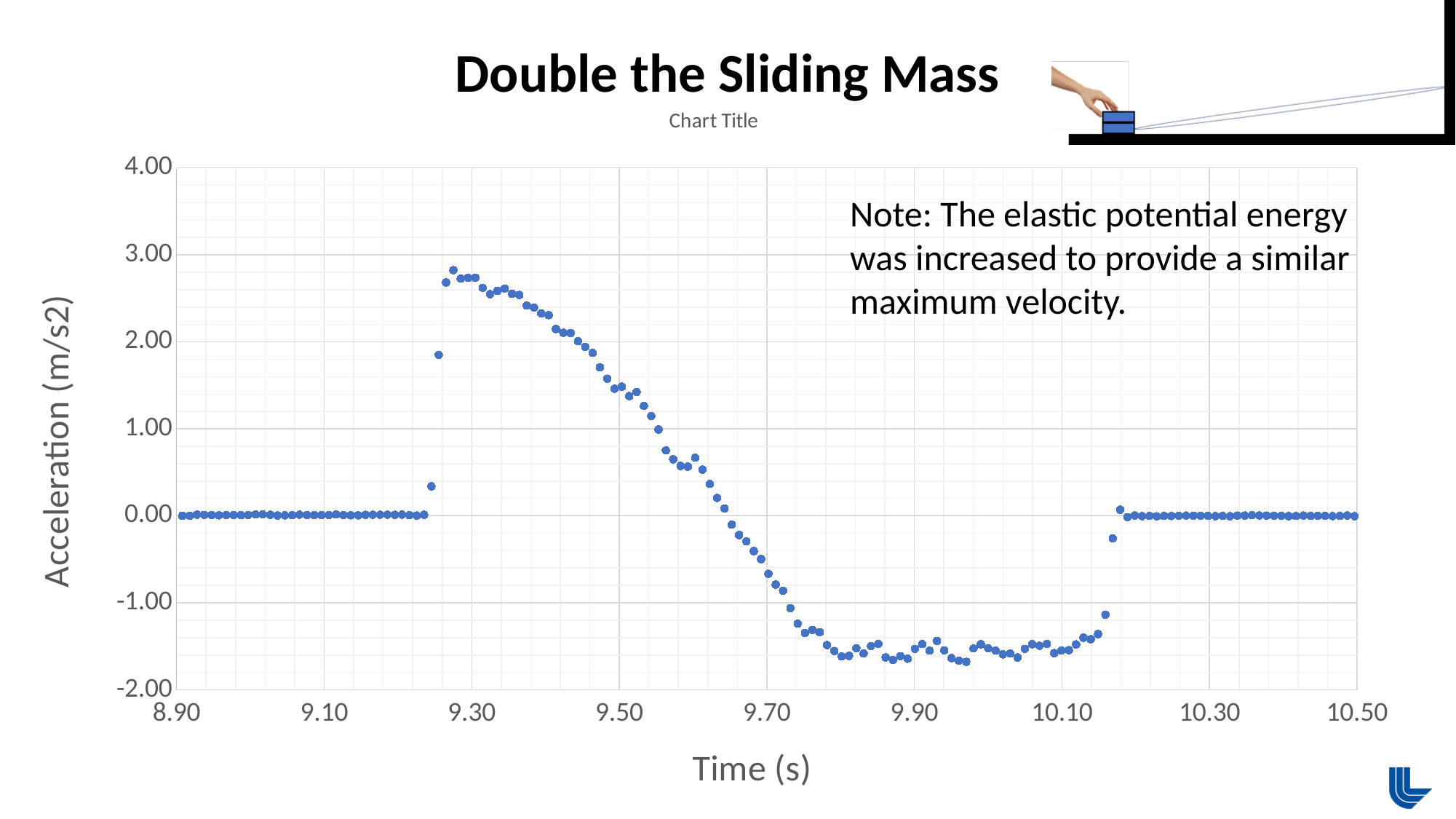
Is the acceleration value at time 10.30 greater or less than 1.00? less Is the acceleration value at time 10.10 greater or less than -1.00? less Between time 9.30 and time 9.70, do the acceleration values rise or fall? fall Is the acceleration value at time 9.50 greater or less than 1.00? greater What is the title of the chart's horizontal axis? Time (s) What is the title of the chart's vertical axis? Acceleration (m/s2) What is the highest tick value shown on the vertical axis? 4.00 Is the acceleration value at time 9.30 larger or smaller than the value at time 9.90? larger What kind of chart is shown on the slide? scatter chart